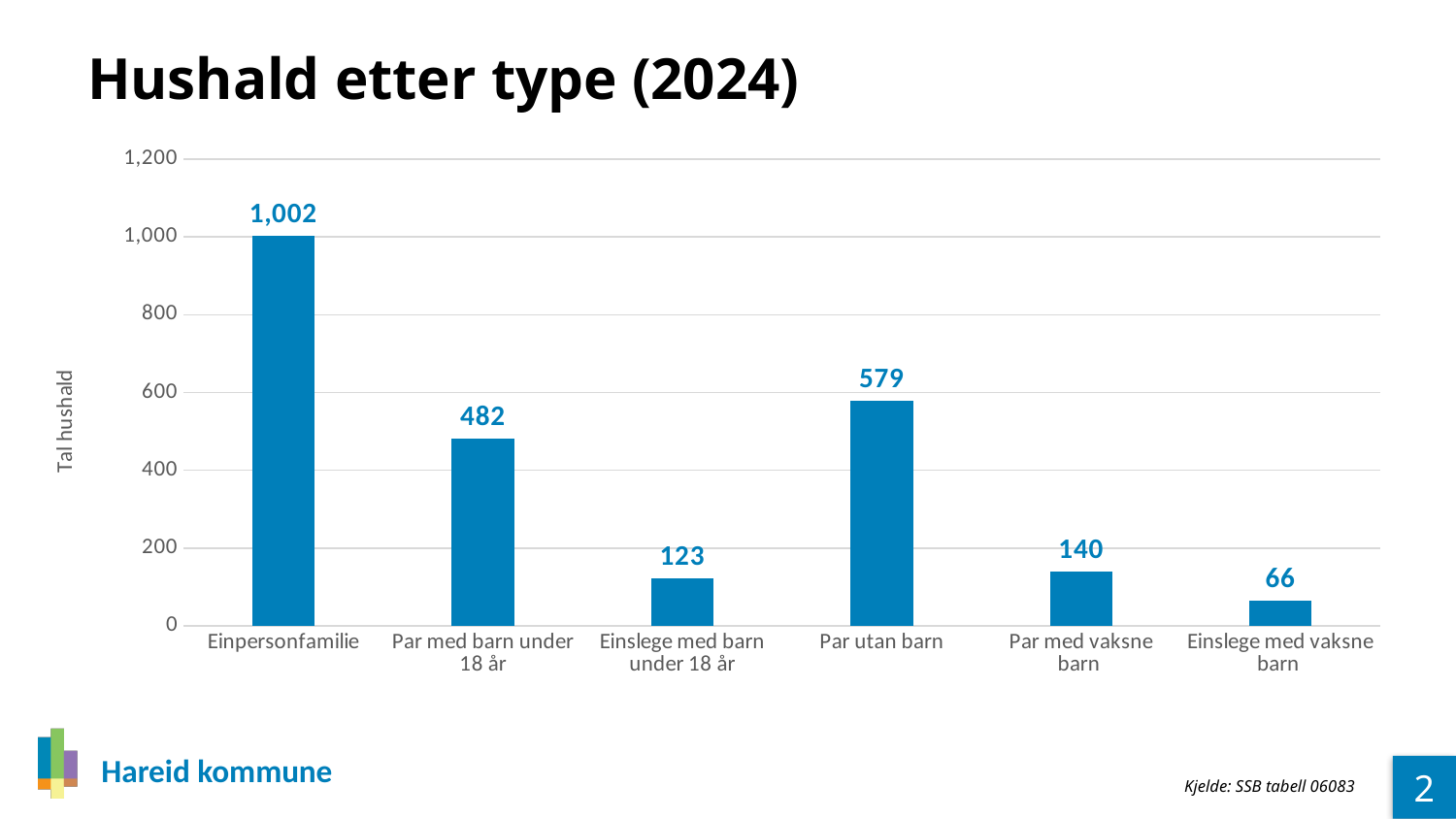
What is the difference between Par med vaksne barn and Einslege med vaksne barn? 74 What is the difference between Einpersonfamilie and Par utan barn? 423 What is the title of the chart? Hushald etter type (2024) Which category has the lowest value? Einslege med vaksne barn What is the value for Einslege med vaksne barn? 66 What is the value for Einpersonfamilie? 1,002 What is the value for Par utan barn? 579 Is the value for Einslege med barn under 18 år greater or less than 200? less What kind of chart is shown on the slide? bar chart Which is larger, Par med barn under 18 år or Par utan barn? Par utan barn How many categories are shown on the x axis? 6 Which category has the highest value? Einpersonfamilie